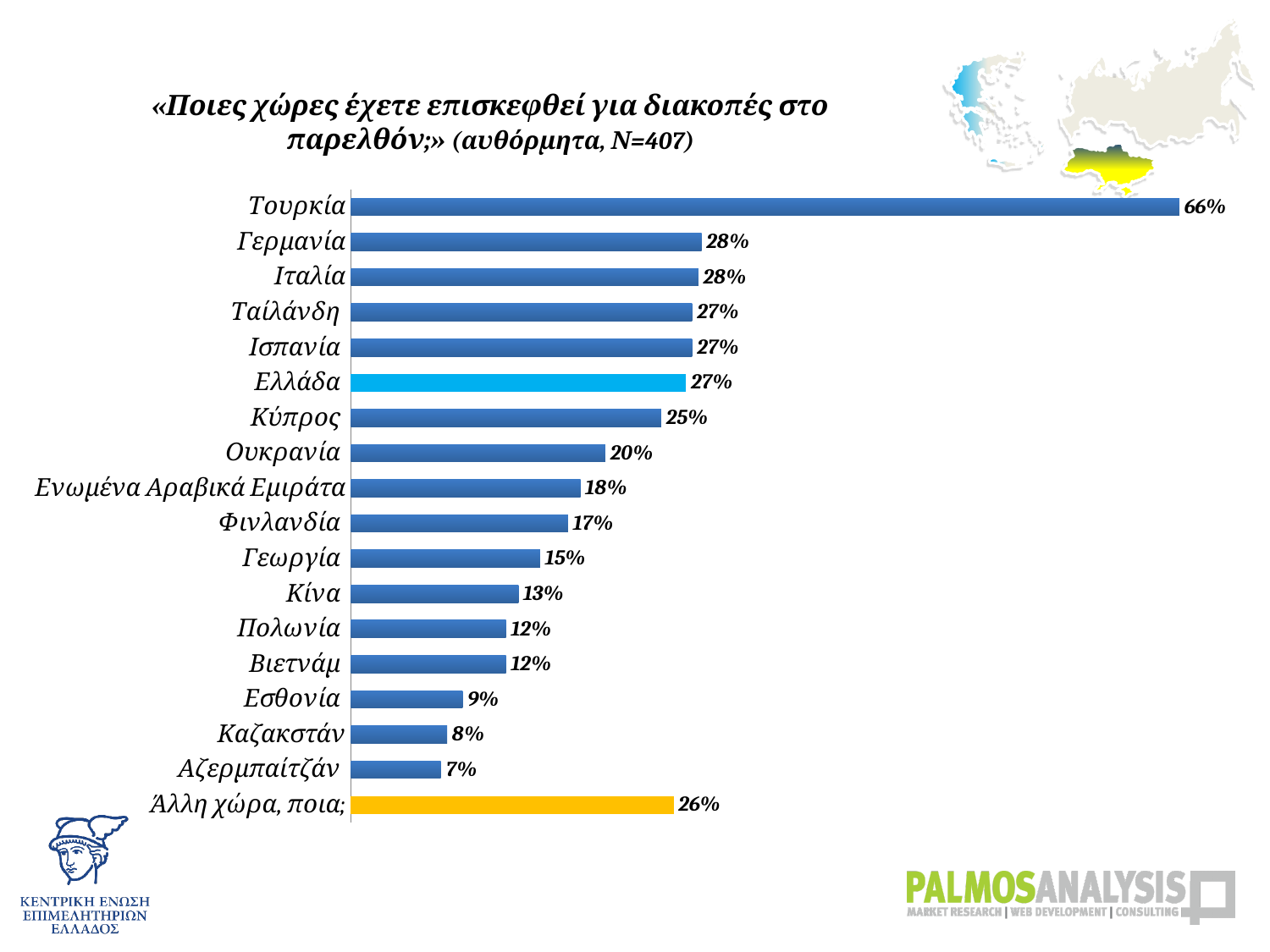
How many categories are shown in the chart? 18 Which country has the highest value? Τουρκία What kind of chart is shown on the slide? Bar chart What is the difference between the values for Κύπρος and Φινλανδία? 8% What is the difference between the values for Τουρκία and Γερμανία? 38% Which category has the lowest value? Αζερμπαϊτζάν Which bar is shown in orange rather than blue? Άλλη χώρα, ποια; What is the value for Ελλάδα? 27% What is the value for Άλλη χώρα, ποια;? 26% Which is larger, the value for Γεωργία or the value for Κίνα? Γεωργία What is the value for Τουρκία? 66% What is the value for Ουκρανία? 20%